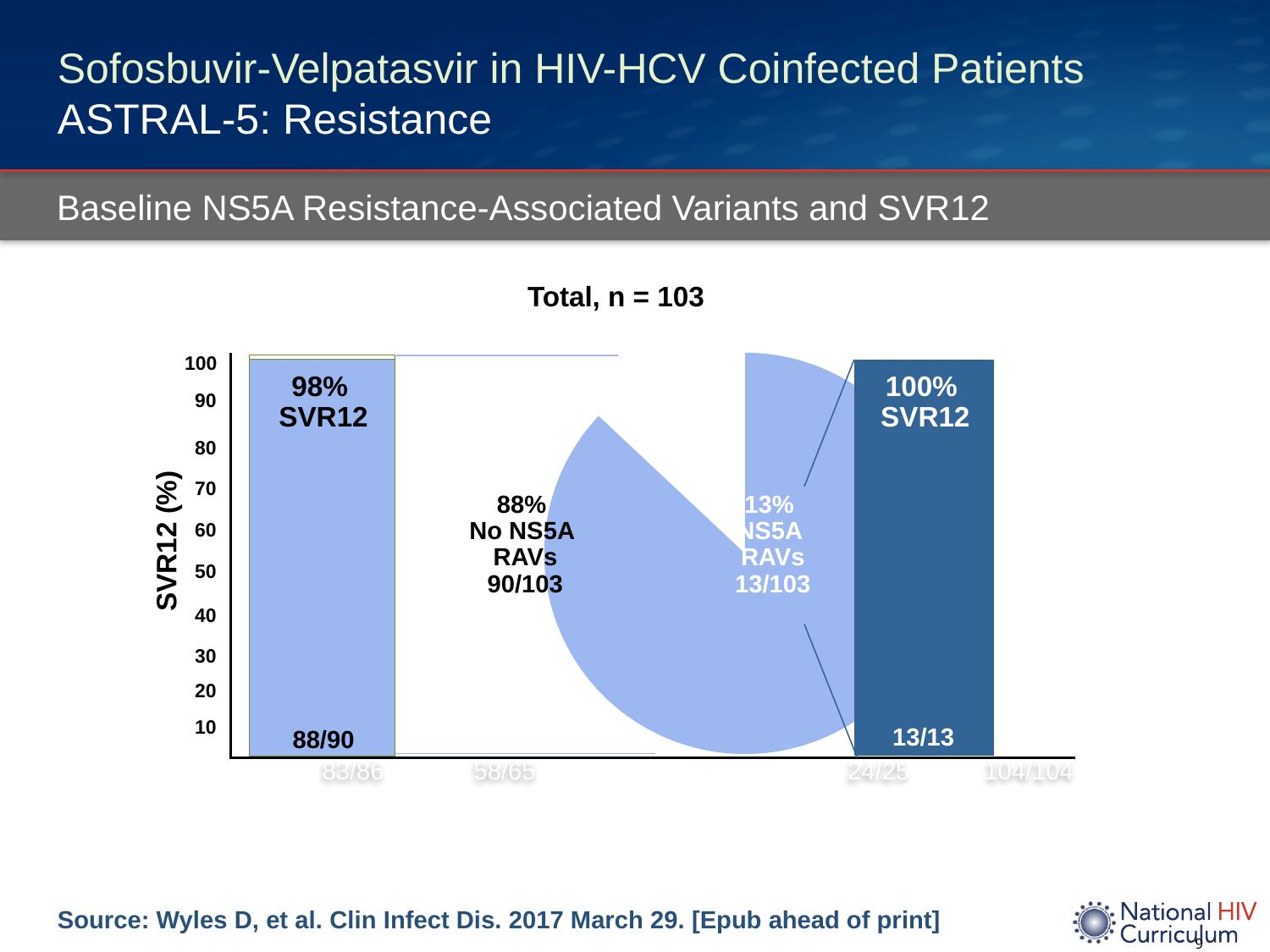
Which bar shows the higher SVR12 rate, the left (no NS5A RAVs) or the right (NS5A RAVs)? right (NS5A RAVs) What SVR12 rate is shown for the left bar (patients with no NS5A RAVs)? 98% In the pie chart, what share of patients had NS5A RAVs? 13% What SVR12 rate is shown for the right bar (patients with NS5A RAVs)? 100% What is the label on the vertical axis of the bar chart? SVR12 (%) In the pie chart, how many patients out of the total had no NS5A RAVs? 90/103 What fraction of patients is printed at the bottom of the right bar? 13/13 What is the total number of patients shown above the pie chart? 103 What fraction of patients is printed at the bottom of the left bar? 88/90 What is the difference in SVR12 rate between the right bar (100%) and the left bar (98%)? 2% In the pie chart, what share of patients had no NS5A RAVs? 88% In the pie chart, how many patients out of the total had NS5A RAVs? 13/103